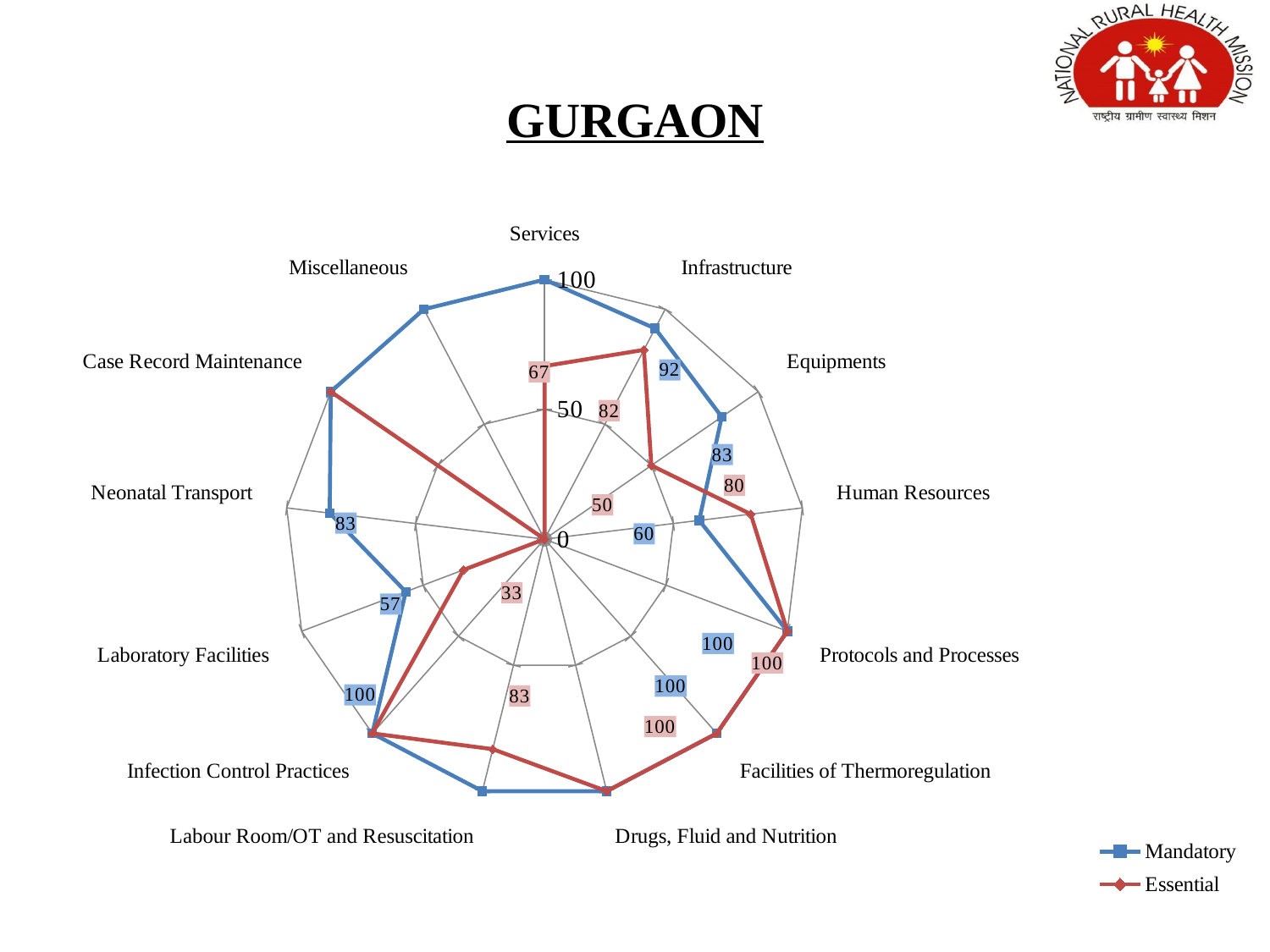
What is the Mandatory value for Human Resources? 60 Is the Mandatory value for Services greater or less than 50? greater What is the Mandatory value for Infrastructure? 92 What is the difference between the Mandatory and Essential values for Laboratory Facilities? 24 What kind of chart is shown on the slide? Radar chart What is the Essential value for Laboratory Facilities? 33 What is the Essential value for Services? 67 Which series has the larger value for Human Resources, Mandatory or Essential? Essential How many series does the legend list? 2 Which category has the lowest Mandatory value? Laboratory Facilities How many categories (axes) does the radar chart have? 13 What are the two series named in the legend? Mandatory and Essential